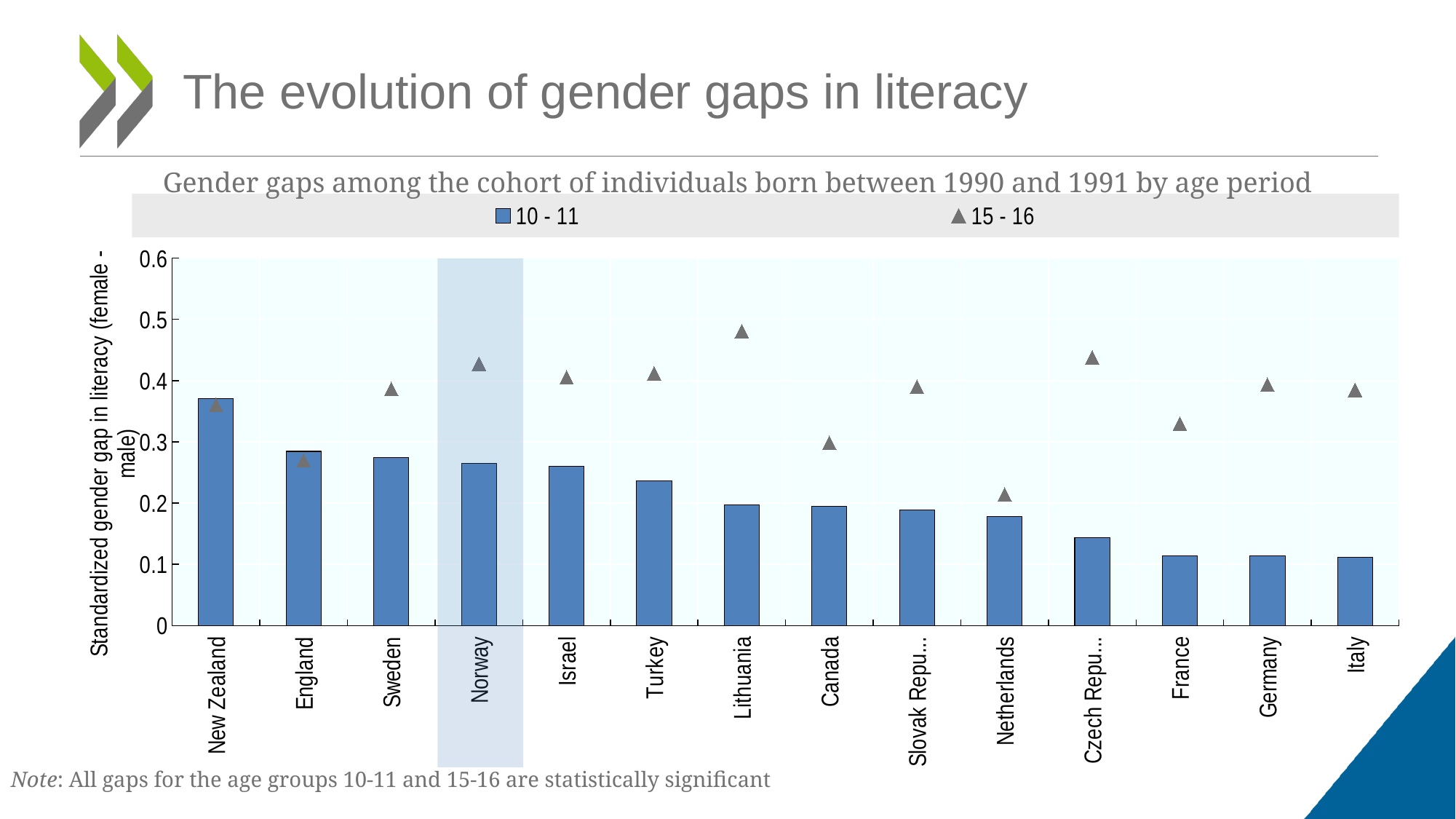
Is the 15 - 16 value for Canada greater or less than 0.4? less What kind of chart is shown on the slide? bar chart How many countries are shown on the x axis? 14 Which country has the highest value for the 10 - 11 series? New Zealand Do the 10 - 11 values rise or fall from left to right across the countries? fall Is the 15 - 16 value for Norway greater or less than 0.4? greater Which country has the lowest value for the 15 - 16 series? Netherlands Which country has the highest value for the 15 - 16 series? Lithuania Is the 10 - 11 value for Czech Republic greater or less than 0.2? less How many series does the legend list? 2 For Norway, which is larger: the 10 - 11 value or the 15 - 16 value? 15 - 16